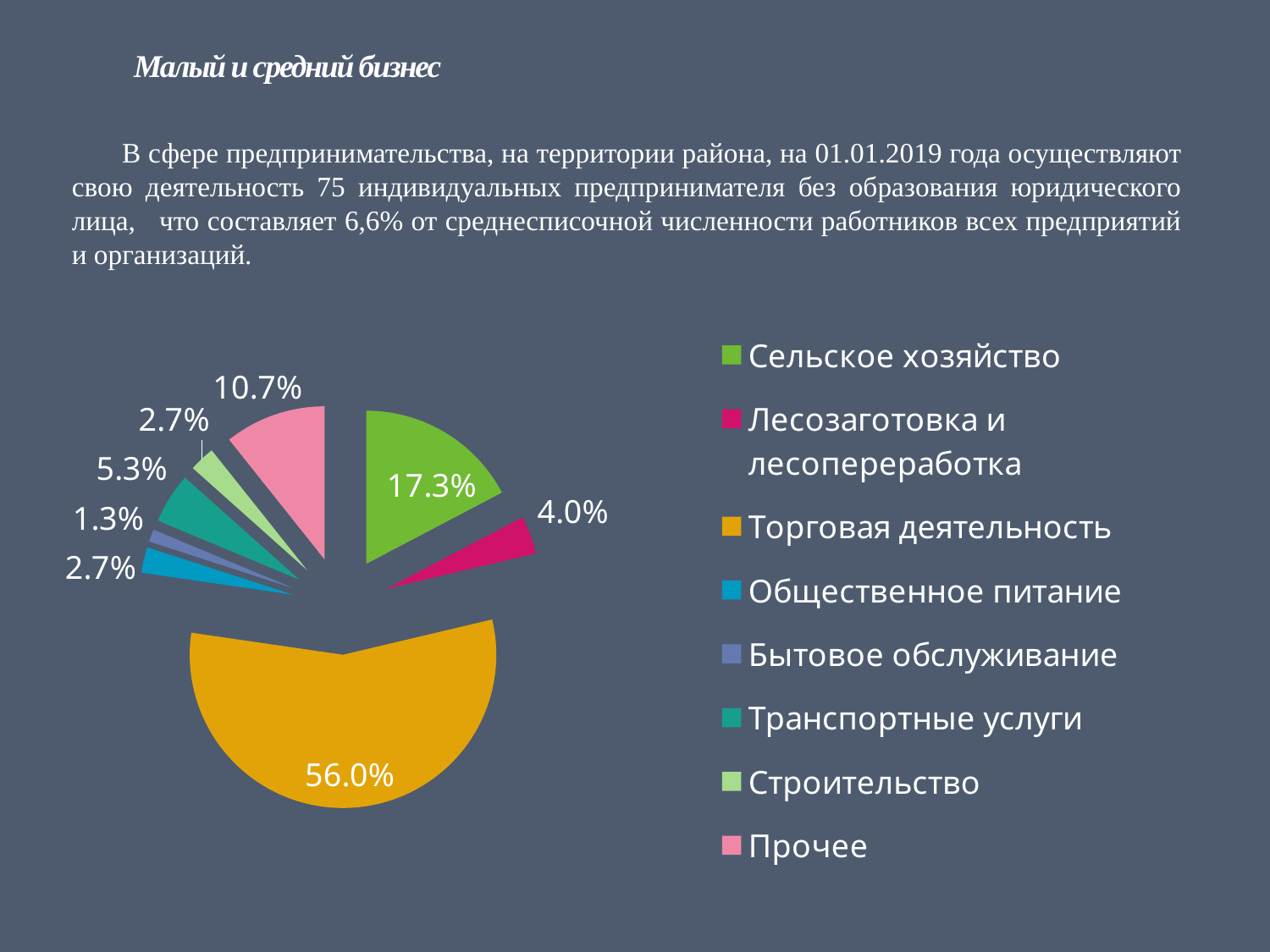
What is the difference between the shares of Торговая деятельность and Сельское хозяйство? 38.7% Which category has the smallest slice of the pie? Бытовое обслуживание What type of chart is shown on the slide? pie chart What is the value shown for Транспортные услуги? 5.3% What is the value shown for Прочее? 10.7% What is the value shown for Сельское хозяйство? 17.3% What is the value shown for Лесозаготовка и лесопереработка? 4.0% Which is larger, the share of Прочее or the share of Транспортные услуги? Прочее What colour is the slice for Торговая деятельность? orange Which category has the largest slice of the pie? Торговая деятельность What share of the pie does Торговая деятельность have? 56.0% How many categories does the legend list? 8